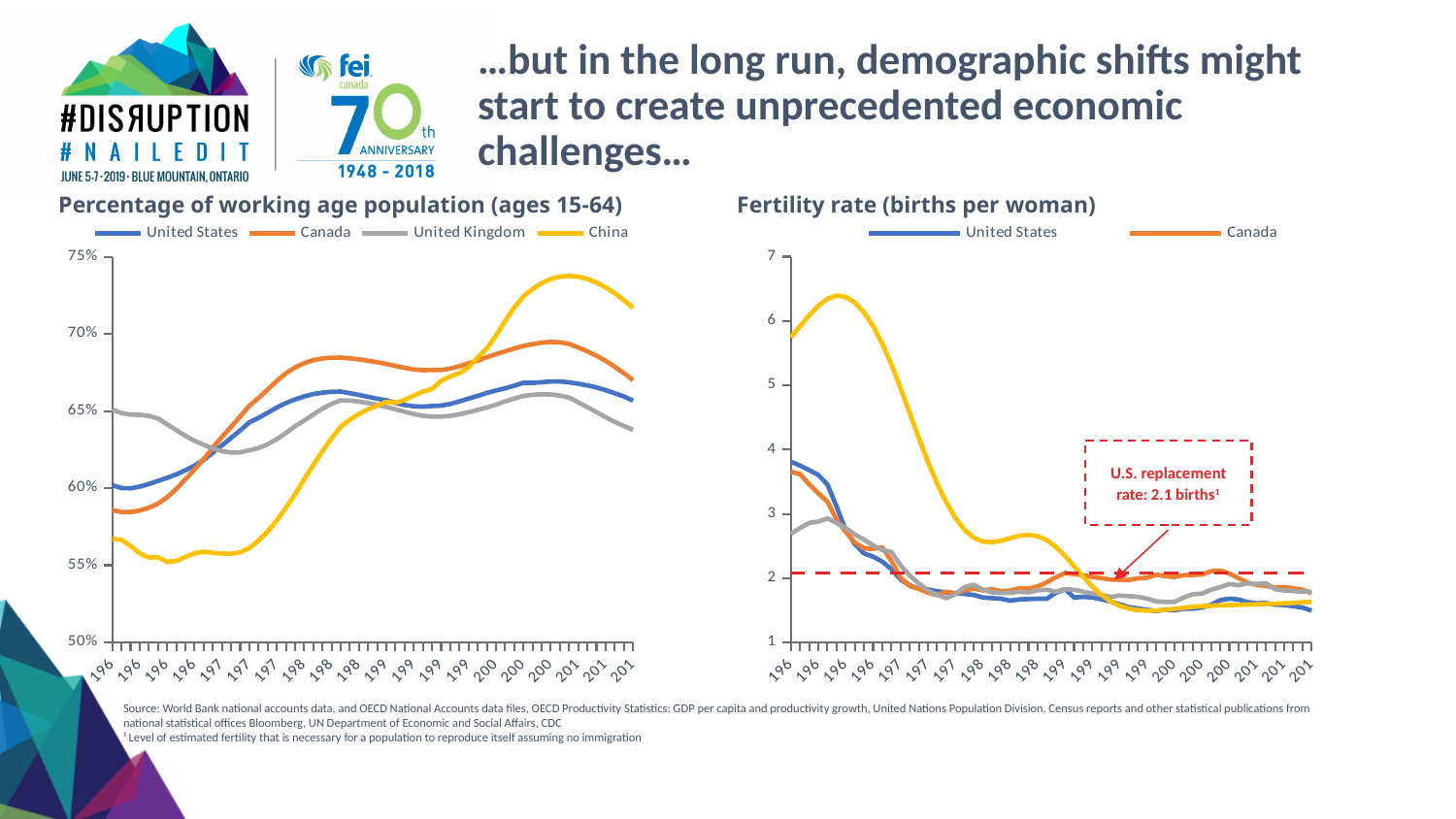
How many series does the legend of the 'Percentage of working age population (ages 15-64)' chart list? 4 In the 'Fertility rate (births per woman)' chart, is the final value for Canada greater or less than 2? less In the 'Fertility rate (births per woman)' chart, what U.S. replacement rate does the annotation give? 2.1 births In the 'Fertility rate (births per woman)' chart, is the starting value for the United States greater or less than 3? greater In the 'Percentage of working age population (ages 15-64)' chart, which series has the lowest value at the left end of the chart? China In the 'Percentage of working age population (ages 15-64)' chart, is the starting value for China greater or less than 60%? less What kind of chart is the 'Percentage of working age population (ages 15-64)' chart? Line chart In the 'Fertility rate (births per woman)' chart, does the United States line generally rise or fall from left to right? Fall In the 'Percentage of working age population (ages 15-64)' chart, which series has the highest value at the right end of the chart? China How many series does the legend of the 'Fertility rate (births per woman)' chart list? 2